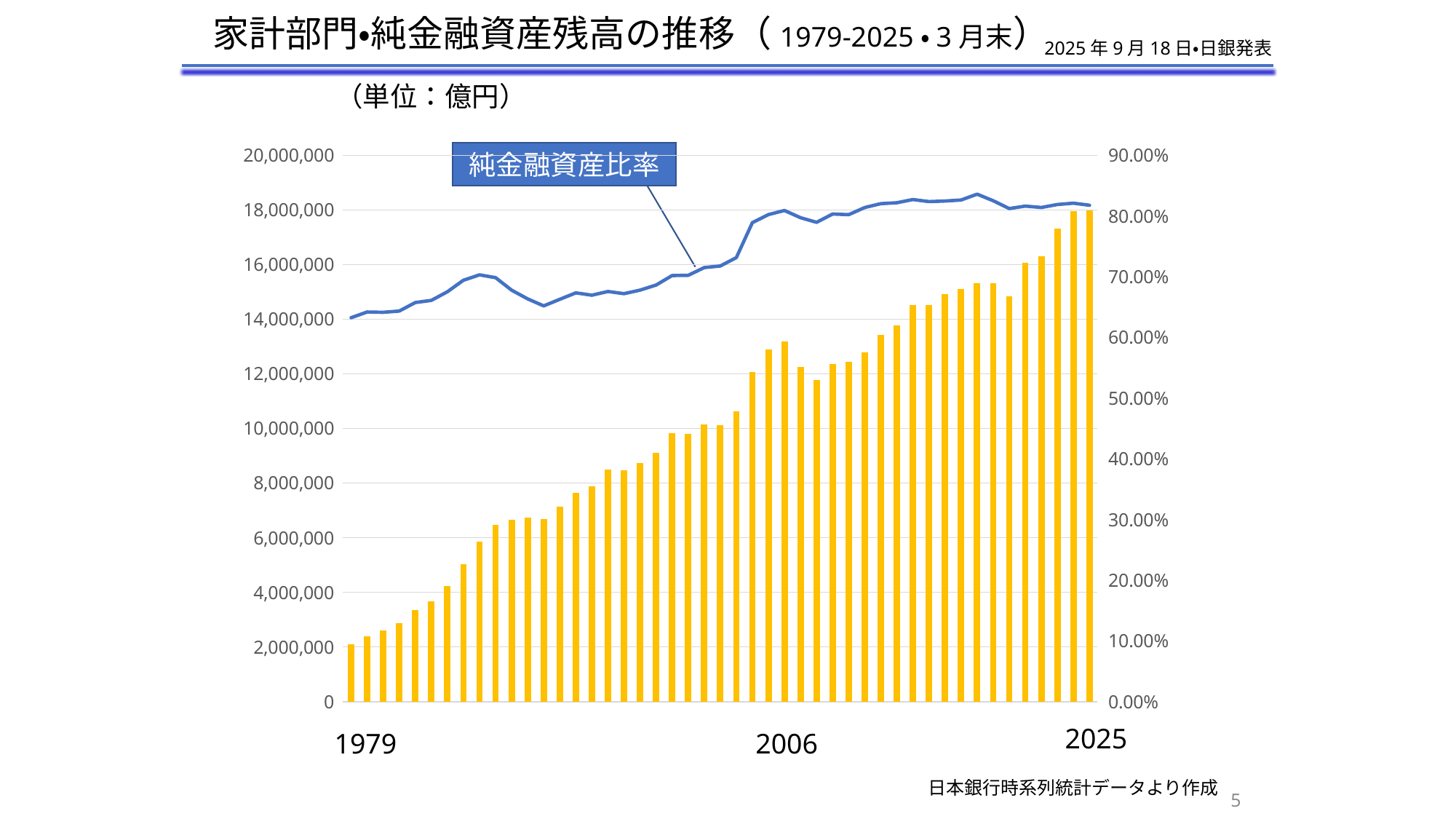
What kind of chart is shown on the slide? A combination of a bar chart and a line chart Is the bar value for 2006 greater or less than 10,000,000? greater Is the bar value for 1979 greater or less than 4,000,000? less Do the bar values generally rise or fall from 1979 to 2025? Rise What is the label shown in the blue box pointing to the line series? 純金融資産比率 How many bars are plotted in the chart (one per year from 1979 to 2025)? 47 Does the 純金融資産比率 line generally rise or fall from 1979 to 2025? Rise Is the 純金融資産比率 value for 1979 greater or less than 50.00%? greater Which year has the highest bar value, 1979 or 2025? 2025 What unit is stated for the bar values on the slide? 億円